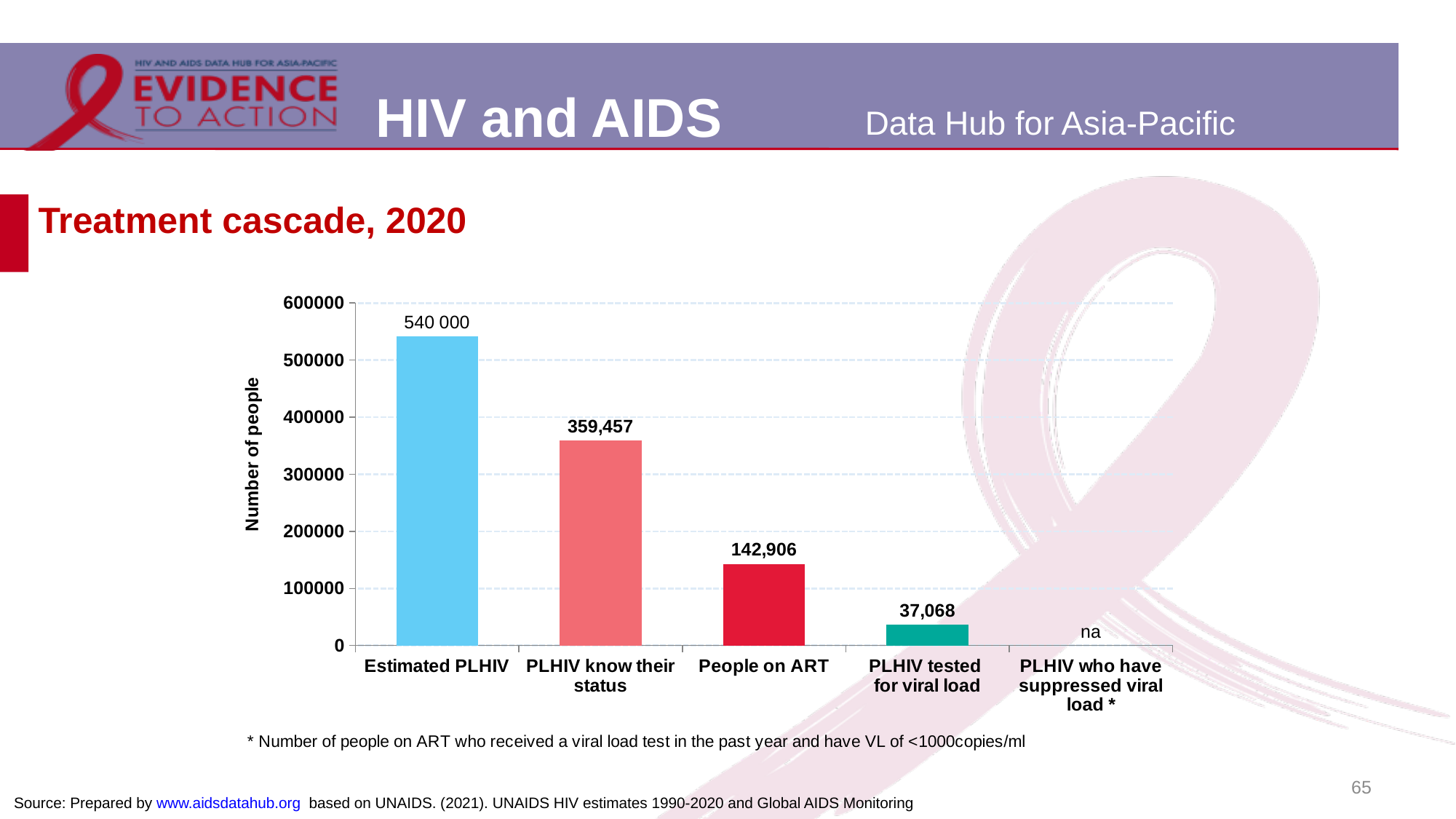
What is shown as the value for PLHIV who have suppressed viral load? na What is the difference between People on ART and PLHIV tested for viral load? 105,838 What type of chart is shown on the slide? bar chart What is the difference between Estimated PLHIV and PLHIV know their status? 180,543 What is the value for People on ART? 142,906 What is the value for Estimated PLHIV? 540 000 What is the value for PLHIV know their status? 359,457 How many categories are shown on the x axis? 5 What is the value for PLHIV tested for viral load? 37,068 Which category with a plotted bar has the lowest value? PLHIV tested for viral load Which category has the highest value? Estimated PLHIV Which is larger, PLHIV know their status or People on ART? PLHIV know their status